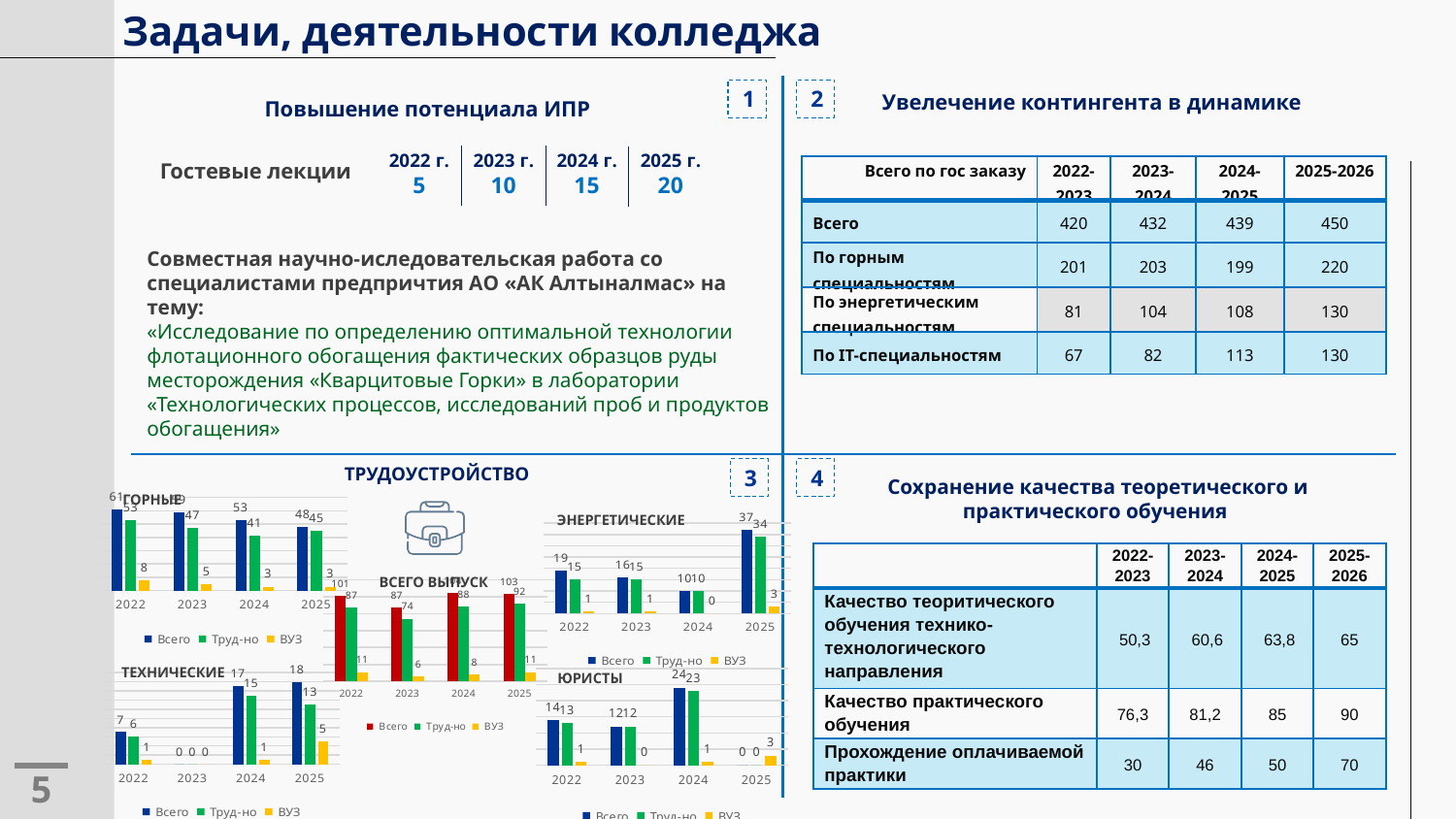
In the ГОРНЫЕ chart, what is the difference between Всего and Труд-но for 2022? 8 How many series does the legend of the ГОРНЫЕ chart list? 3 In the ЭНЕРГЕТИЧЕСКИЕ chart, what is the value of Труд-но for 2025? 34 What kind of chart is the ЭНЕРГЕТИЧЕСКИЕ chart in the ТРУДОУСТРОЙСТВО section? bar chart How many year categories are shown on the x axis of the ЮРИСТЫ chart? 4 In the ТЕХНИЧЕСКИЕ chart, which is larger: Всего for 2024 or Всего for 2025? 2025 In the ЮРИСТЫ chart, what is the value of Всего for 2024? 24 In the ЮРИСТЫ chart, which year has the highest Труд-но value? 2024 In the ЭНЕРГЕТИЧЕСКИЕ chart, what is the value of Всего for 2025? 37 In the ЭНЕРГЕТИЧЕСКИЕ chart, which year has the highest Всего value? 2025 In the ГОРНЫЕ chart, what is the value of ВУЗ for 2022? 8 In the ТЕХНИЧЕСКИЕ chart, what is the value of ВУЗ for 2025? 5